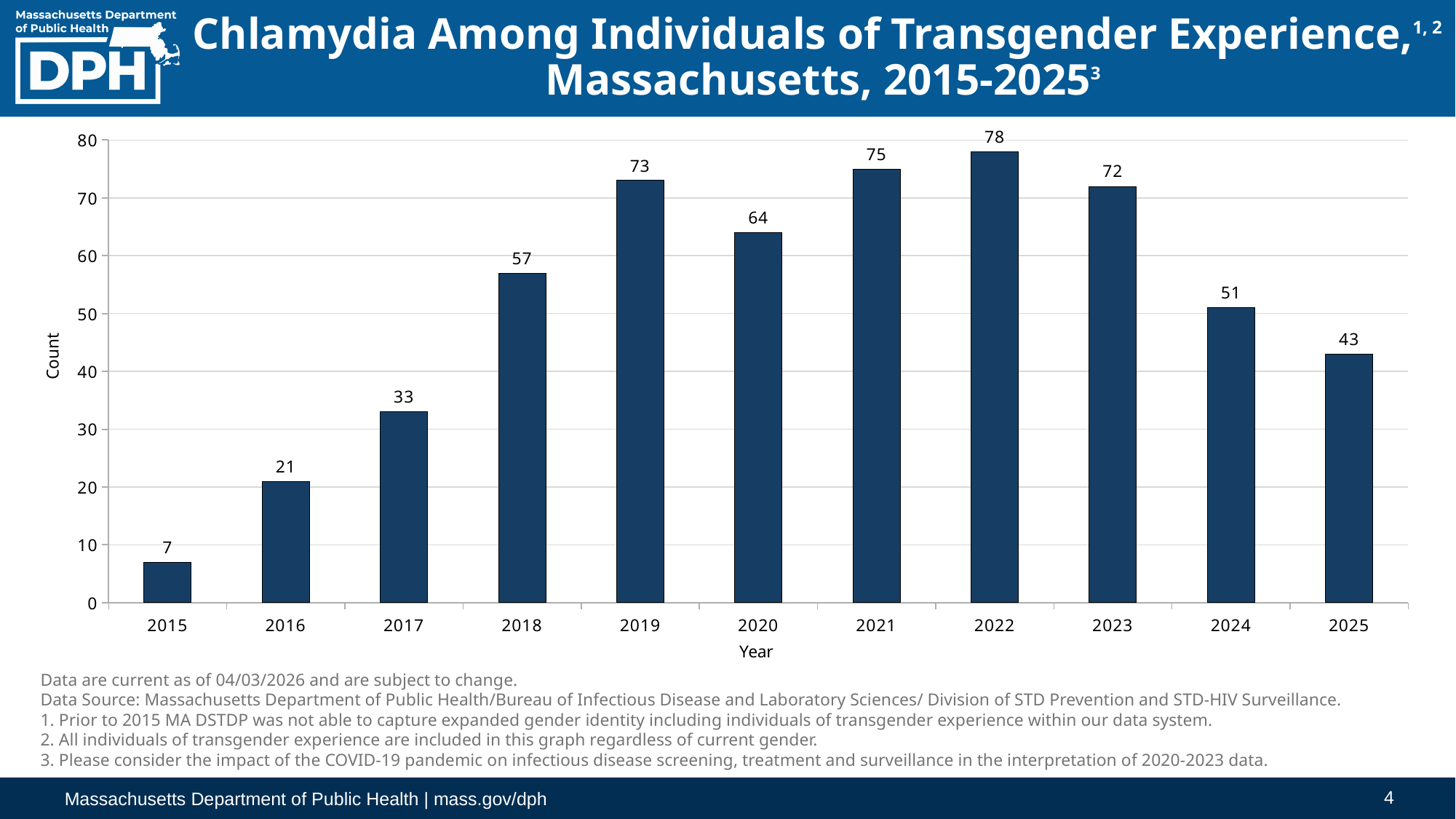
What is the count for 2019? 73 Is the count for 2024 greater or less than 60? less Which year has a larger count, 2020 or 2023? 2023 Which year has the highest count? 2022 What is the count for 2015? 7 Do the counts rise or fall from 2015 to 2019? Rise What is the difference between the counts for 2018 and 2017? 24 What kind of chart is shown on the slide? Bar chart How many years are shown on the x axis? 11 Which year has the lowest count? 2015 What is the count for 2025? 43 What is the difference between the counts for 2022 and 2025? 35